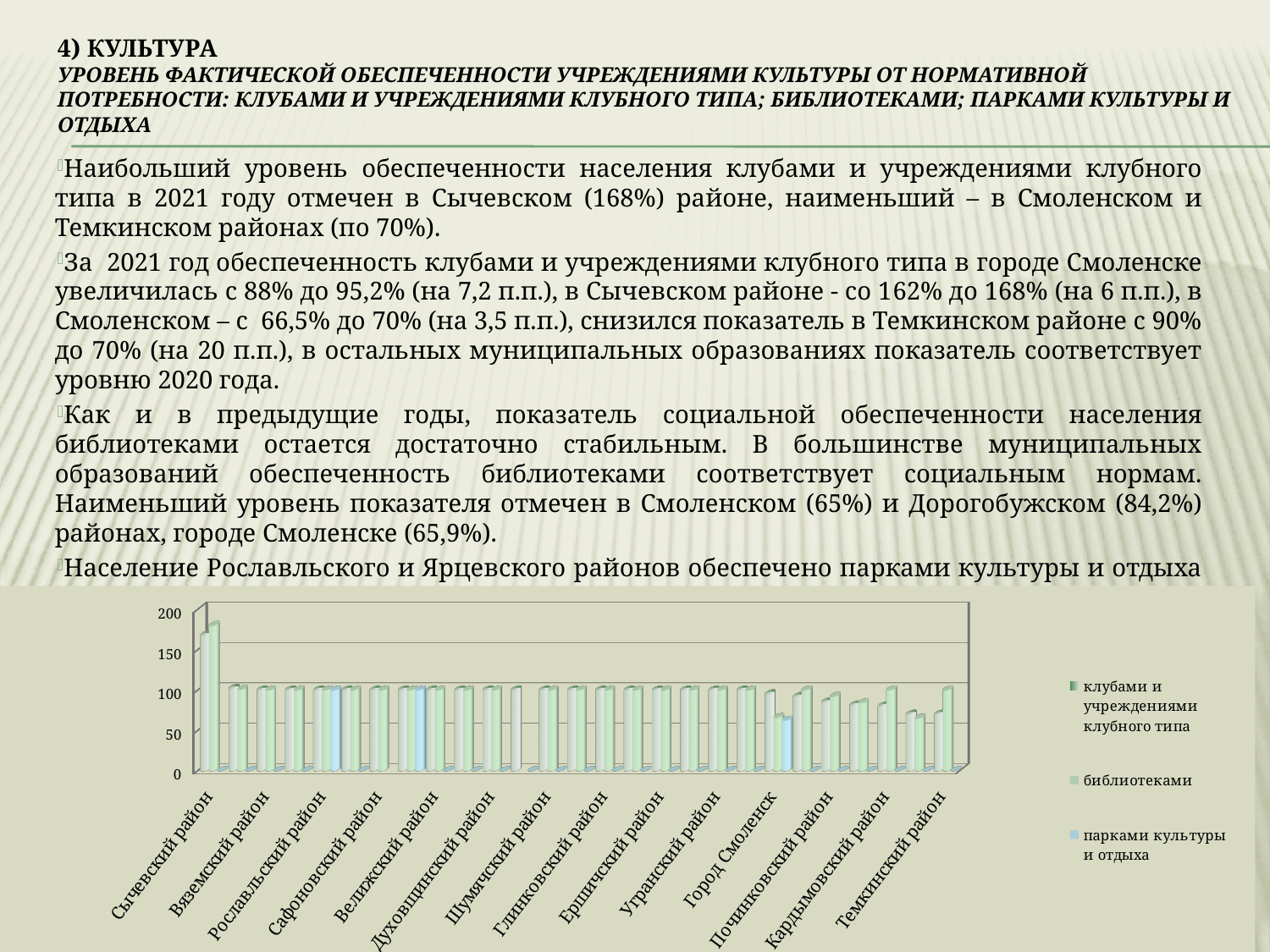
Is the value for 'парками культуры и отдыха' in Сычевский район greater or less than 50? less Is the value for 'клубами и учреждениями клубного типа' in Темкинский район greater or less than 100? less Which series is listed first in the chart legend? клубами и учреждениями клубного типа Is the value for 'библиотеками' in Вяземский район greater or less than 50? greater What kind of chart is shown on the slide? bar chart Which category has the highest value for the series 'клубами и учреждениями клубного типа'? Сычевский район How many series does the chart legend list? 3 Which series is listed last in the chart legend? парками культуры и отдыха Which is larger: the value for 'клубами и учреждениями клубного типа' in Вяземский район or in Темкинский район? Вяземский район Which is larger: the value for 'клубами и учреждениями клубного типа' in Сычевский район or in Вяземский район? Сычевский район